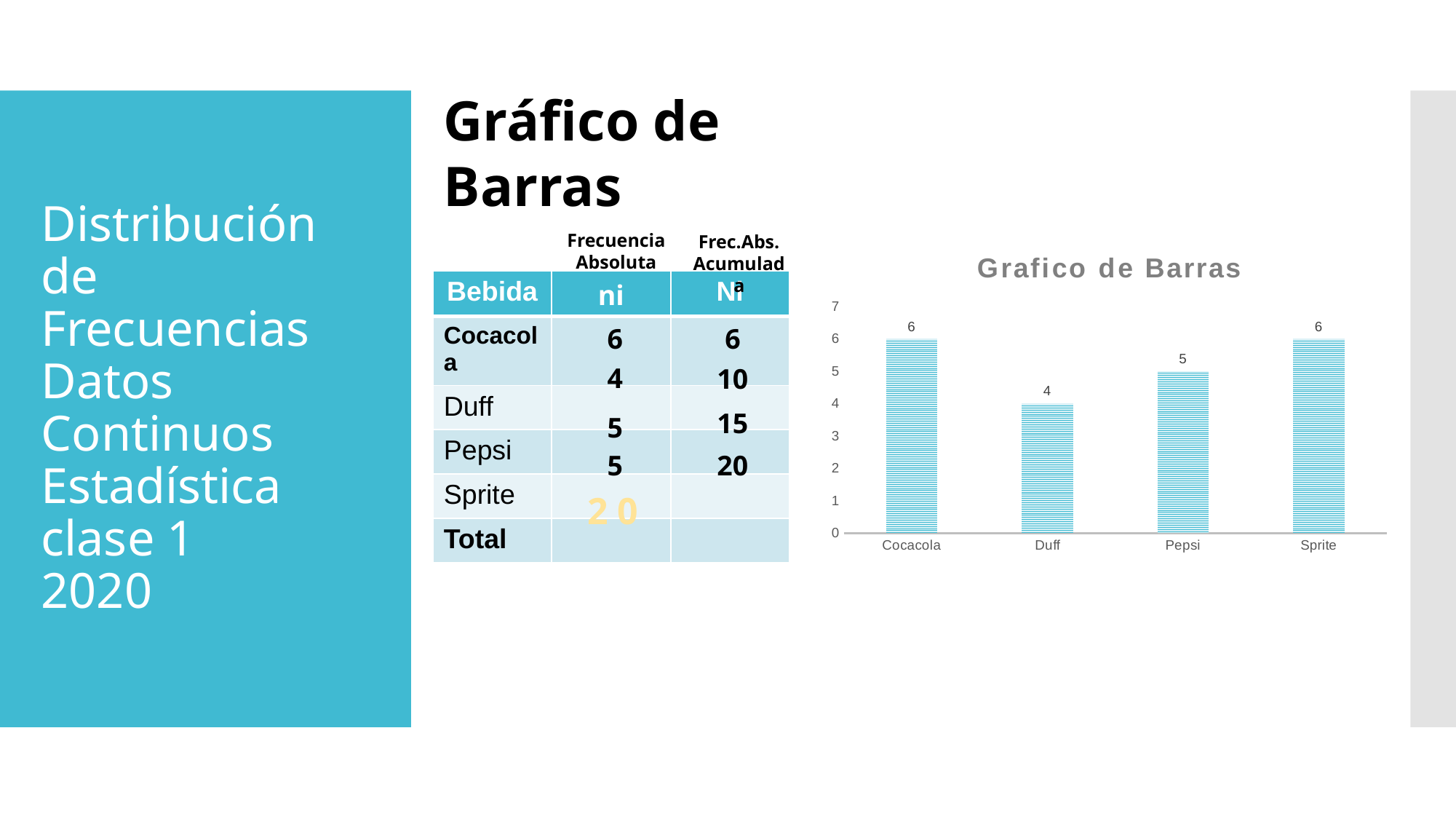
What is the value for Pepsi in the chart? 5 What is the title of the chart? Grafico de Barras Which category has the lowest value in the chart? Duff Which is larger, the value for Pepsi or the value for Duff? Pepsi How many categories are shown on the x axis of the chart? 4 What is the value for Sprite in the chart? 6 What is the value for Duff in the chart? 4 What kind of chart is shown on the slide? bar chart Which is larger, the value for Sprite or the value for Pepsi? Sprite What is the value for Cocacola in the chart? 6 What is the difference between the values for Pepsi and Duff? 1 What is the difference between the values for Cocacola and Duff? 2